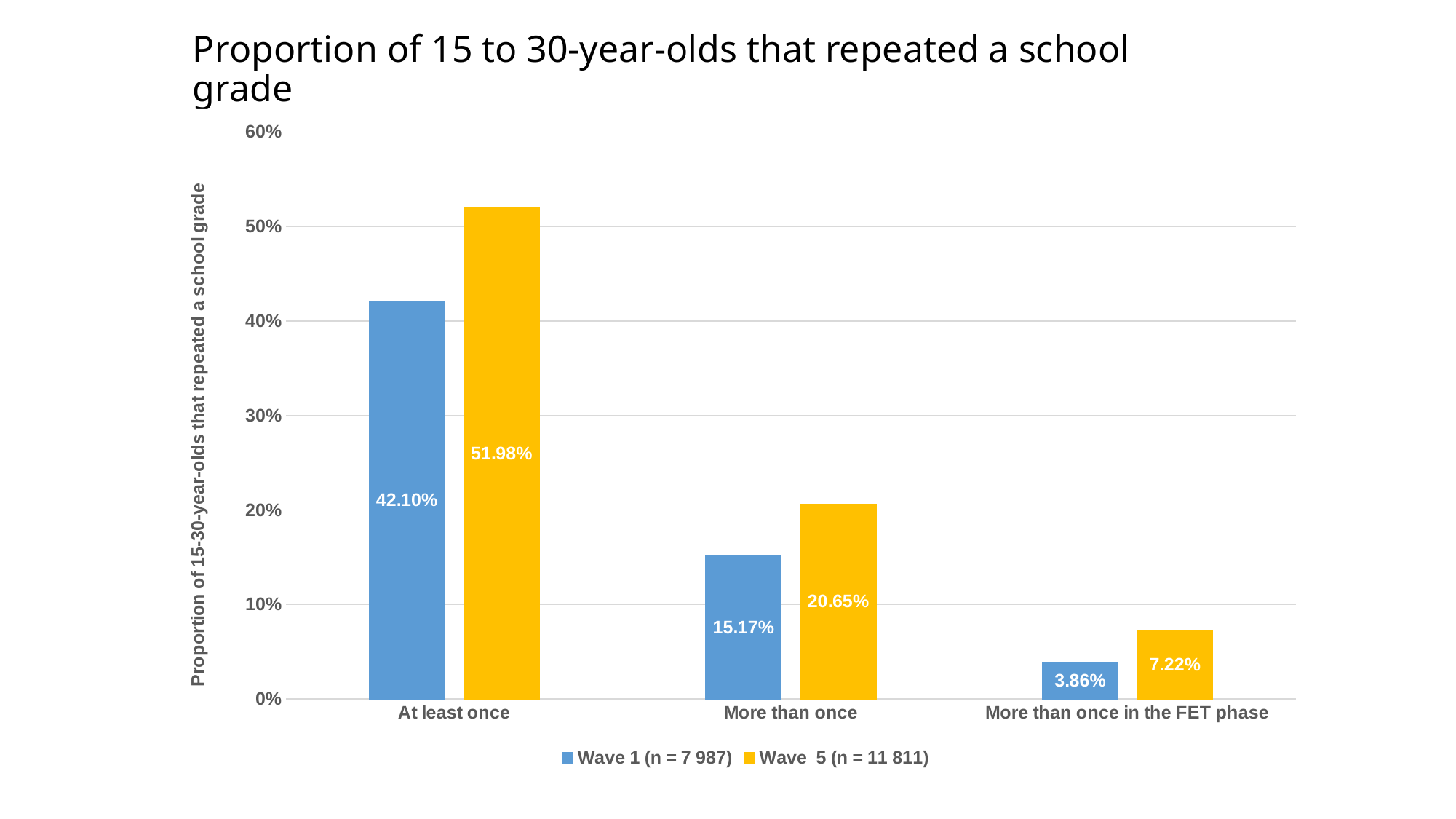
Is the Wave 5 value for 'More than once in the FET phase' greater or less than 10%? less What kind of chart is shown on the slide? Bar chart What is the Wave 5 value for 'At least once'? 51.98% What is the difference between the Wave 5 and Wave 1 values for 'At least once'? 9.88% How many series does the legend list? 2 What is the Wave 1 value for 'More than once in the FET phase'? 3.86% Which is larger for 'More than once': the Wave 1 value or the Wave 5 value? Wave 5 What is the Wave 5 value for 'More than once'? 20.65% Which category has the lowest Wave 1 value? More than once in the FET phase How many categories are shown on the x axis? 3 What is the Wave 1 value for 'At least once'? 42.10% Which category has the highest Wave 5 value? At least once